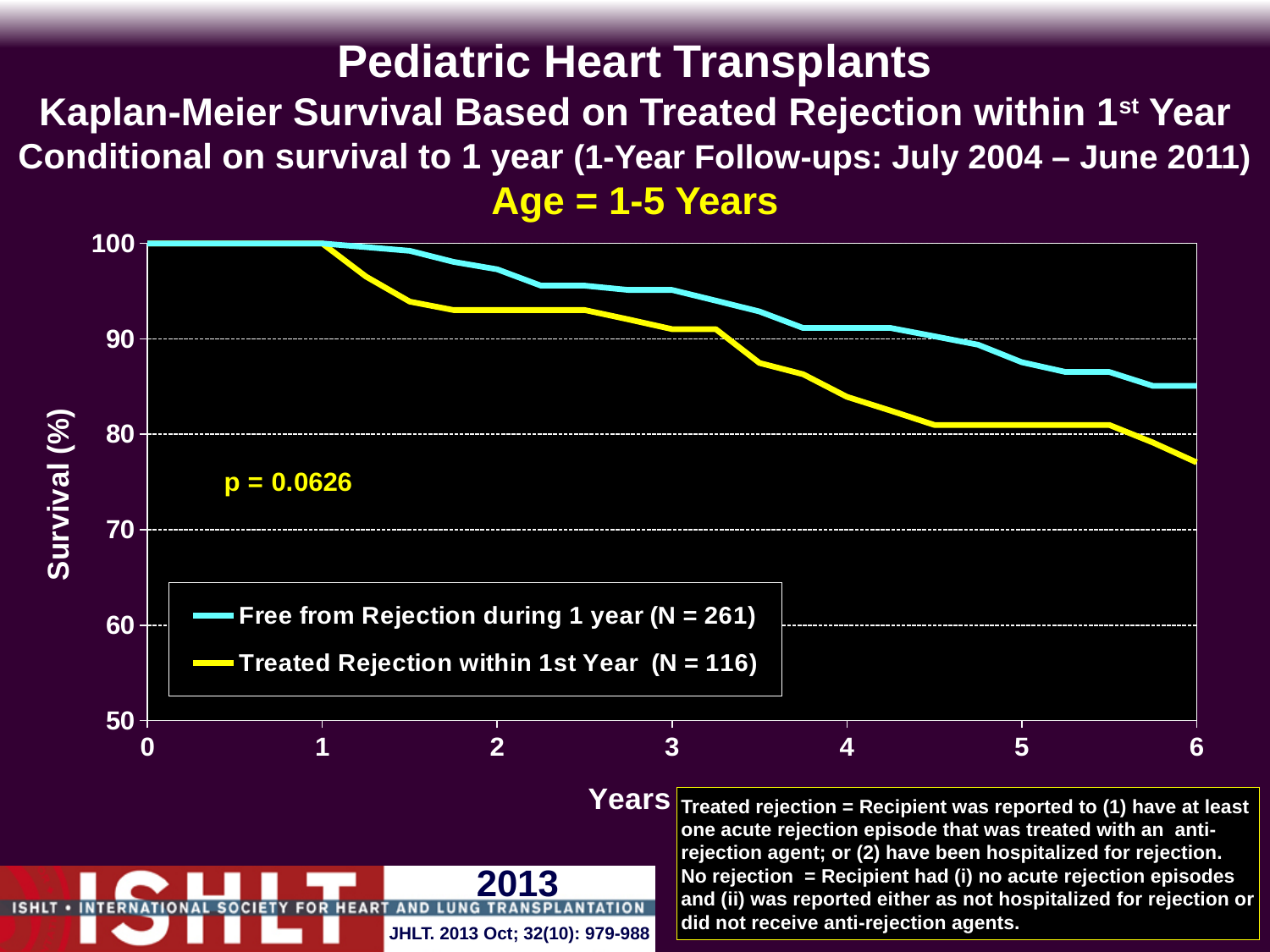
What p-value is printed on the chart? p = 0.0626 What is the survival (%) for the Treated Rejection within 1st Year group at year 0? 100 Is the survival for the Free from Rejection during 1 year group at year 3 greater or less than 90? greater What is the survival (%) for the Free from Rejection during 1 year group at year 0? 100 What kind of chart is shown on the slide? line chart Is the survival for the Free from Rejection during 1 year group at year 6 greater or less than 80? greater At year 6, which group has the higher survival: Free from Rejection during 1 year or Treated Rejection within 1st Year? Free from Rejection during 1 year Is the survival for the Treated Rejection within 1st Year group at year 4 greater or less than 90? less According to the legend, what is N for the Treated Rejection within 1st Year group? 116 Do the survival curves rise or fall as years increase? fall How many series does the legend list? 2